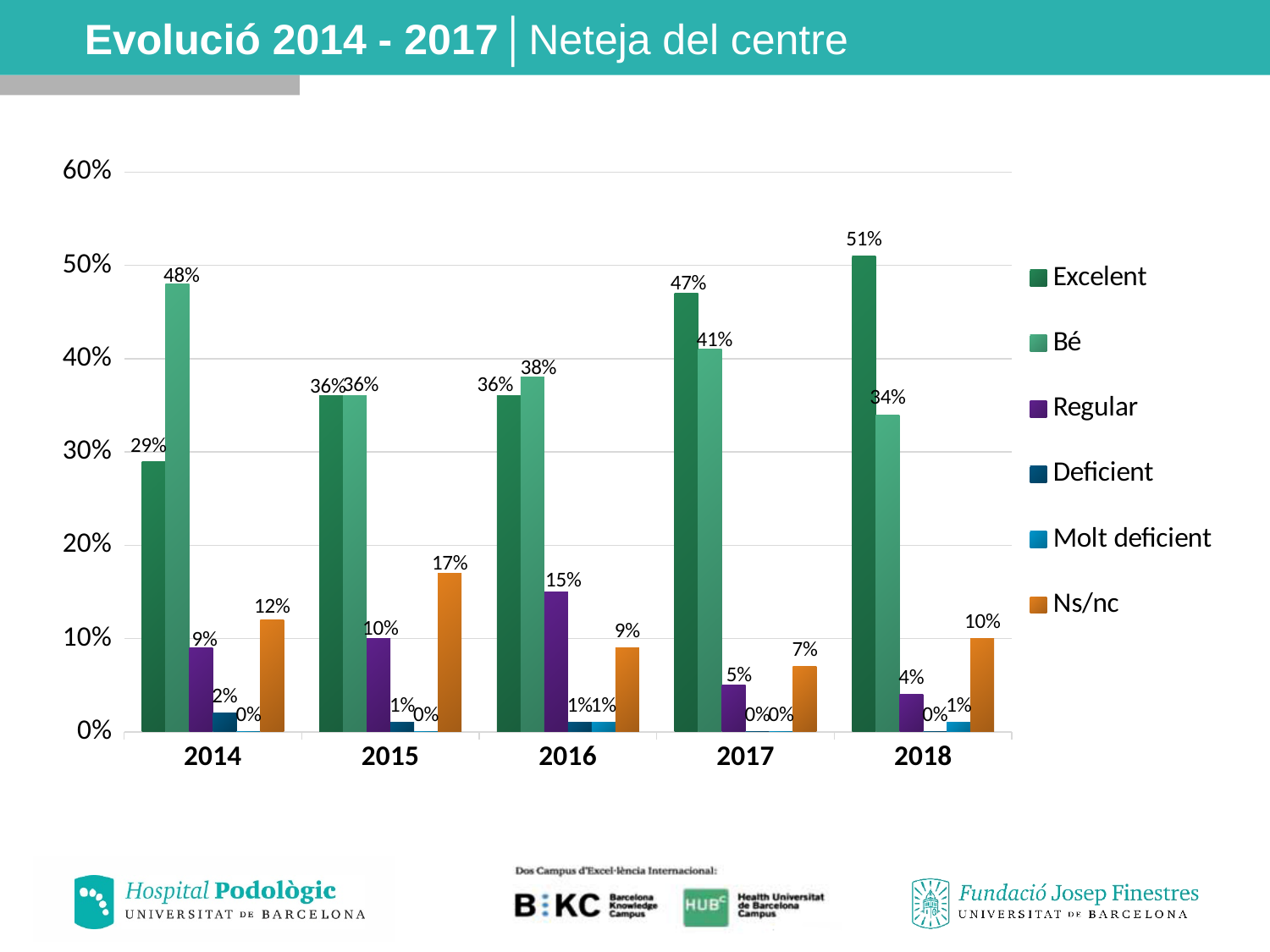
What is the difference between the Excelent and Bé values in 2017? 6% Does the Excelent value rise or fall from 2014 to 2018? Rise What is the value for Excelent in 2018? 51% Which is larger in 2016, Excelent or Bé? Bé How many series does the legend list? 6 In which year is the Regular value lowest? 2018 What is the value for Ns/nc in 2015? 17% What kind of chart is shown on the slide? Bar chart What is the value for Regular in 2016? 15% In which year is the Excelent value highest? 2018 How many years are shown on the x axis? 5 What is the value for Bé in 2014? 48%